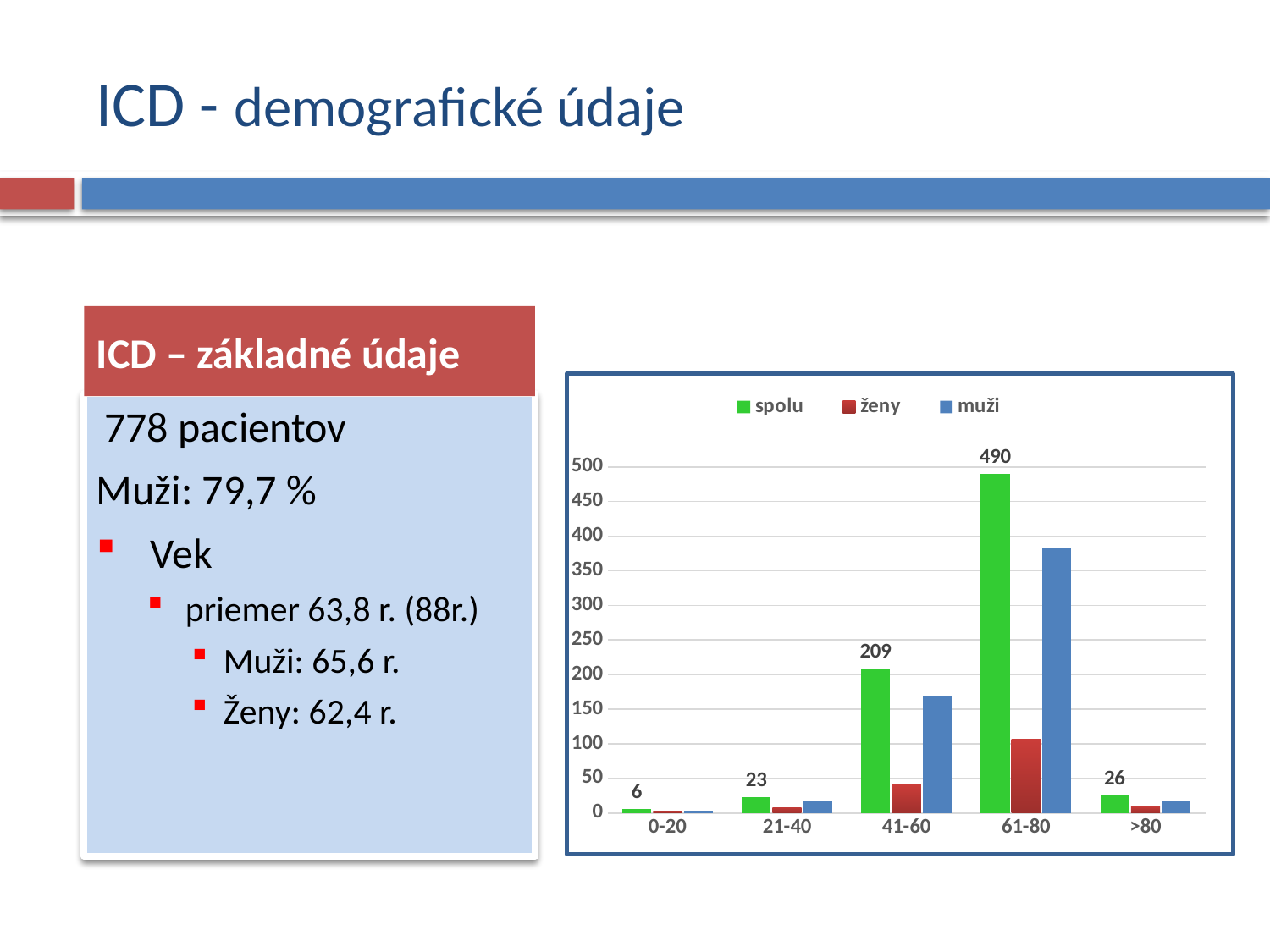
Is the 'ženy' value for the 41-60 age group greater or less than 50? less What is the difference between the 'spolu' values for the 61-80 and 41-60 age groups? 281 Which age group has the lowest 'spolu' value? 0-20 Which age group has the highest 'spolu' value? 61-80 Which is larger, the 'spolu' value for 21-40 or for >80? >80 Is the 'muži' value for the 61-80 age group greater or less than 350? greater What is the value of the 'spolu' series for the 41-60 age group? 209 What is the value of the 'spolu' series for the >80 age group? 26 What is the value of the 'spolu' series for the 61-80 age group? 490 How many age groups are shown on the x axis of the chart? 5 How many series does the chart legend list? 3 What is the value of the 'spolu' series for the 0-20 age group? 6